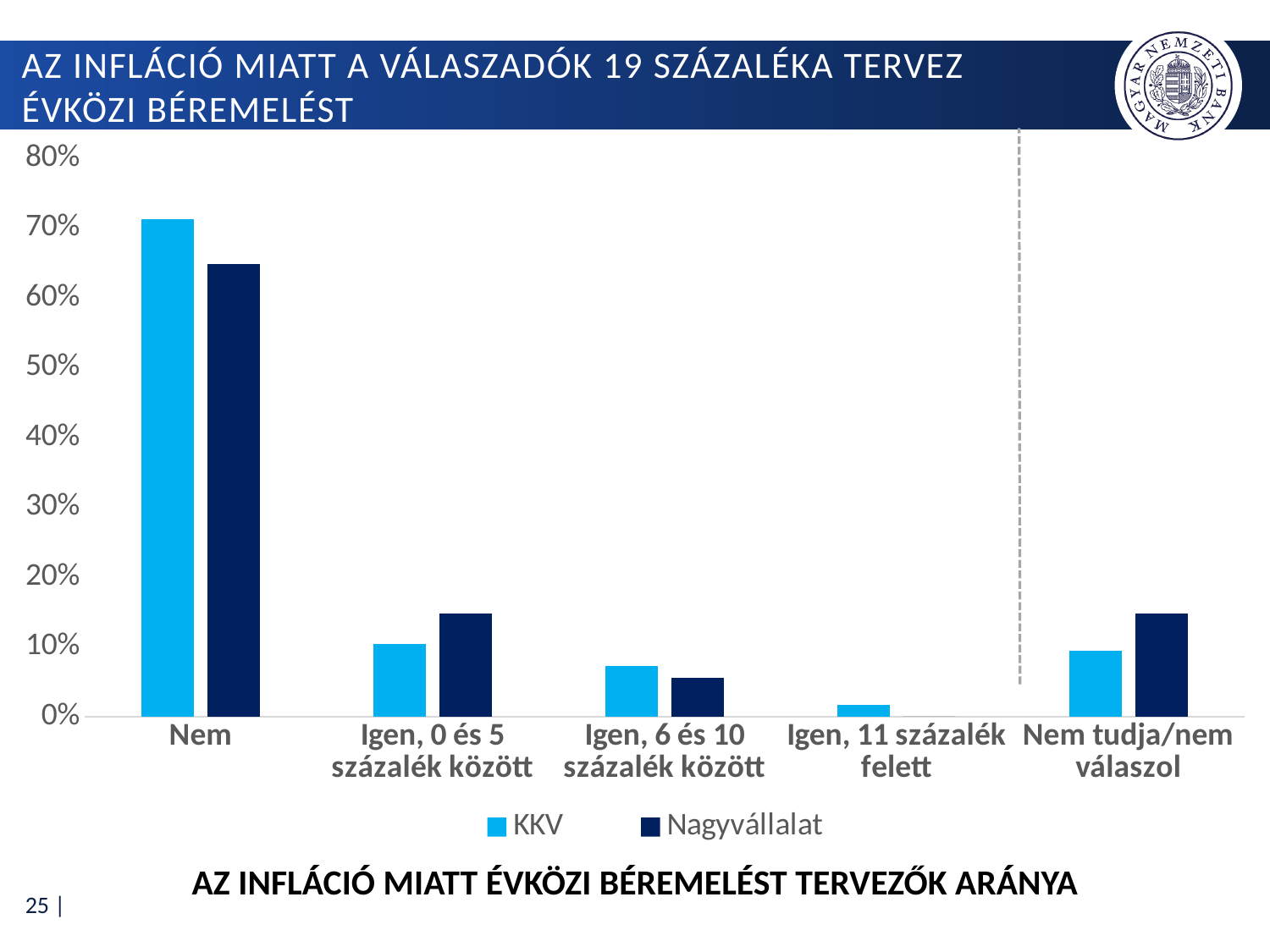
Is the KKV value for 'Nem' greater or less than 60%? greater What kind of chart is shown on the slide? bar chart Which category has the highest value for KKV? Nem For the category 'Nem tudja/nem válaszol', which series has the larger value, KKV or Nagyvállalat? Nagyvállalat For the category 'Nem', which series has the larger value, KKV or Nagyvállalat? KKV What are the two series named in the legend? KKV and Nagyvállalat How many categories are shown on the x axis? 5 Which category has the highest value for Nagyvállalat? Nem Is the Nagyvállalat value for 'Igen, 6 és 10 százalék között' greater or less than 10%? less How many series does the legend list? 2 Which category has the lowest value for KKV? Igen, 11 százalék felett For the category 'Igen, 0 és 5 százalék között', which series has the larger value, KKV or Nagyvállalat? Nagyvállalat